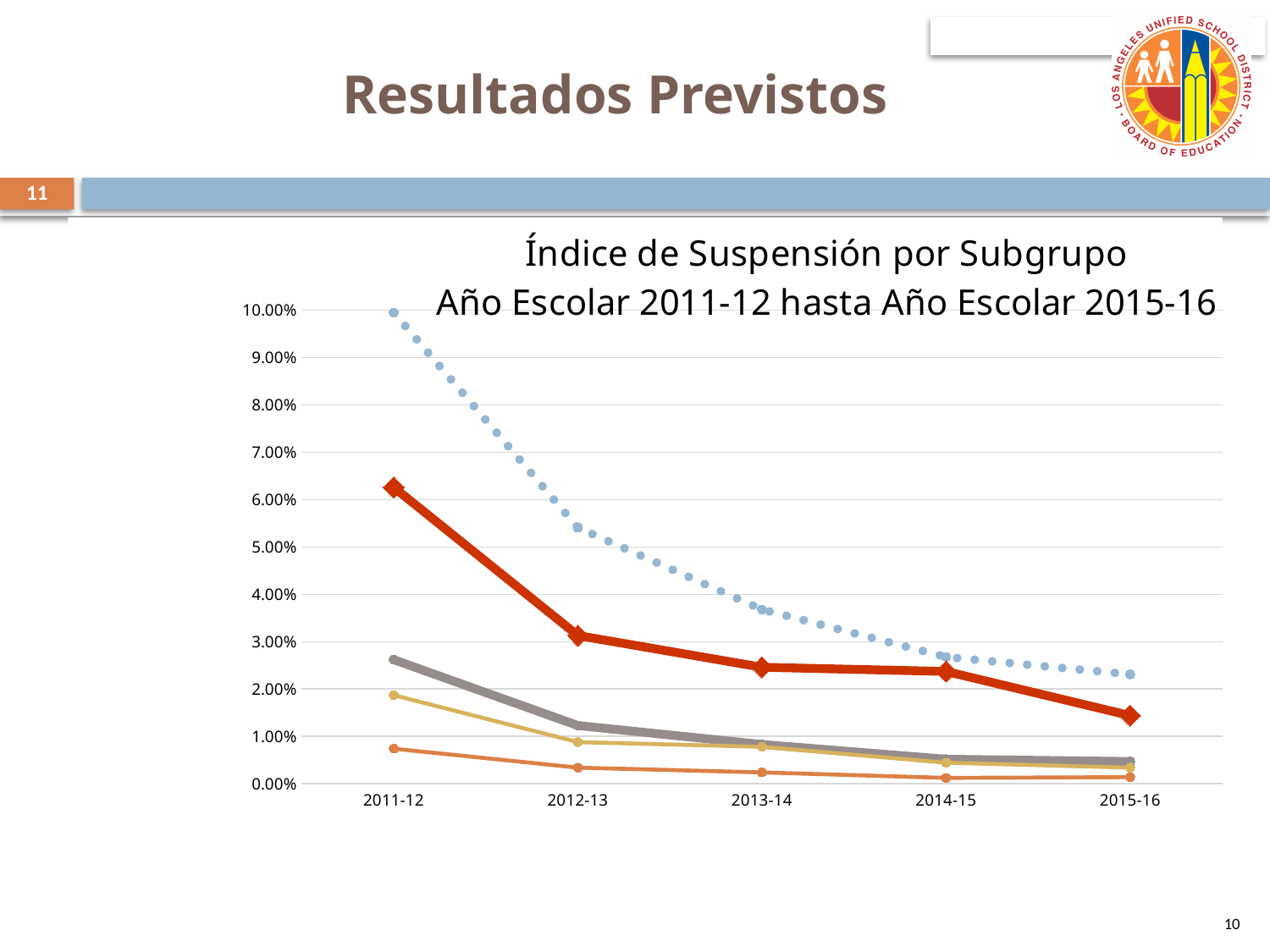
In which school year does the dotted blue line reach its highest value? 2011-12 How many lines are plotted on the chart? 5 In which school year does the thick red line reach its lowest value? 2015-16 Do the suspension rates generally rise or fall from 2011-12 to 2015-16? fall Is the value of the thick red line in 2011-12 greater or less than 5.00%? greater Is the value of the thick red line in 2015-16 greater or less than 2.00%? less Is the value of the dotted blue line in 2011-12 greater or less than 9.00%? greater What is the title of the chart? Índice de Suspensión por Subgrupo Año Escolar 2011-12 hasta Año Escolar 2015-16 How many school years are shown on the x axis of the chart? 5 In 2011-12, which line has the higher value, the dotted blue line or the thick red line? the dotted blue line What kind of chart is shown on the slide? line chart